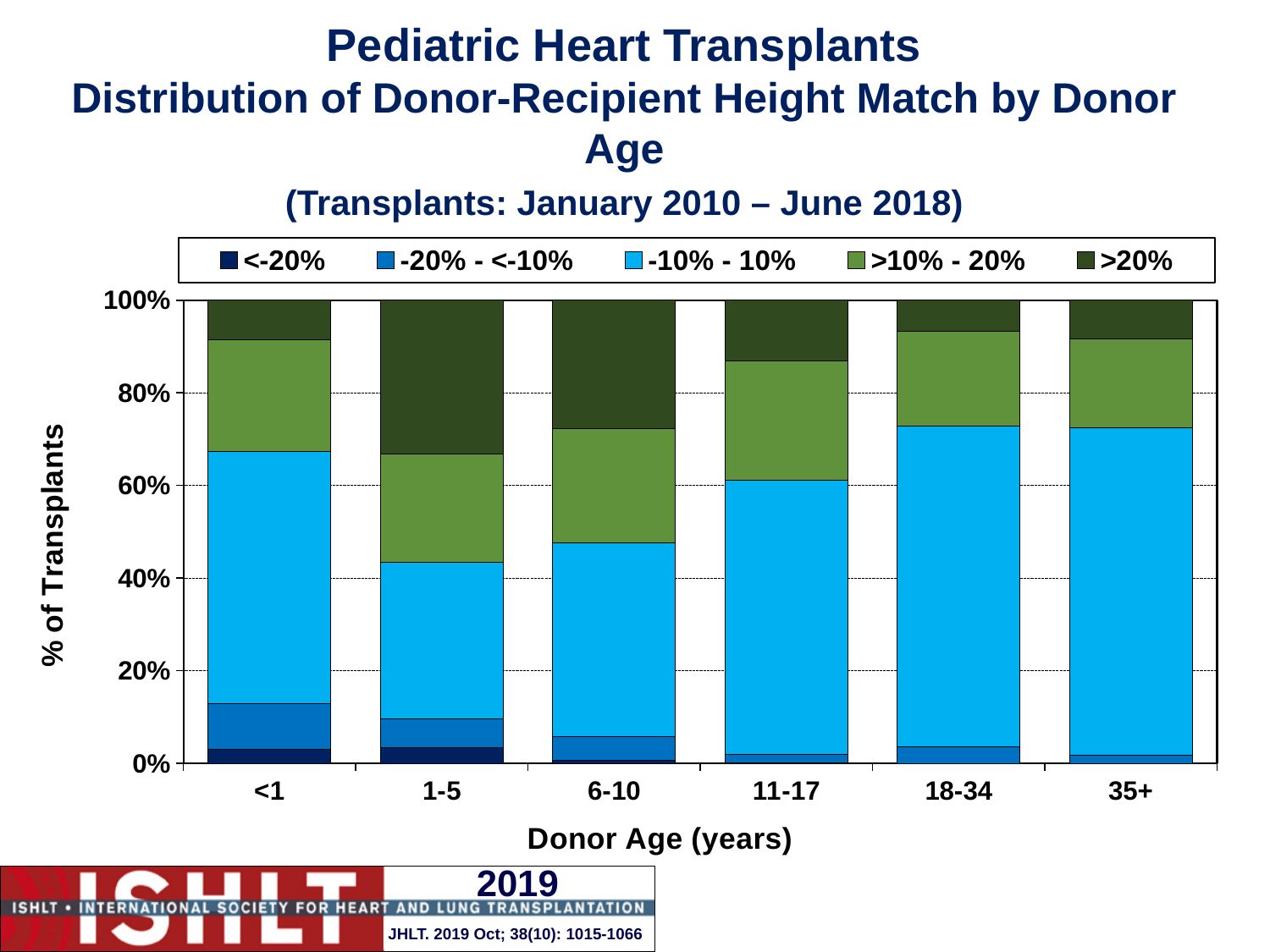
Is the share of the >20% segment for donor age <1 greater or less than 20%? less Which donor age group has the largest >20% segment? 1-5 How many donor age categories are shown on the x axis? 6 What is the label of the x axis? Donor Age (years) How many series does the legend list? 5 What kind of chart is shown on the slide? Stacked bar chart Which donor age group has the smallest -10% - 10% segment? 1-5 Is the >20% segment larger for donor age 1-5 or for donor age 18-34? 1-5 Is the -10% - 10% segment larger for donor age 18-34 or for donor age 1-5? 18-34 Is the share of the -10% - 10% segment for donor age 1-5 greater or less than 40%? less Is the share of the -10% - 10% segment for donor age 18-34 greater or less than 60%? greater What is the label of the y axis? % of Transplants